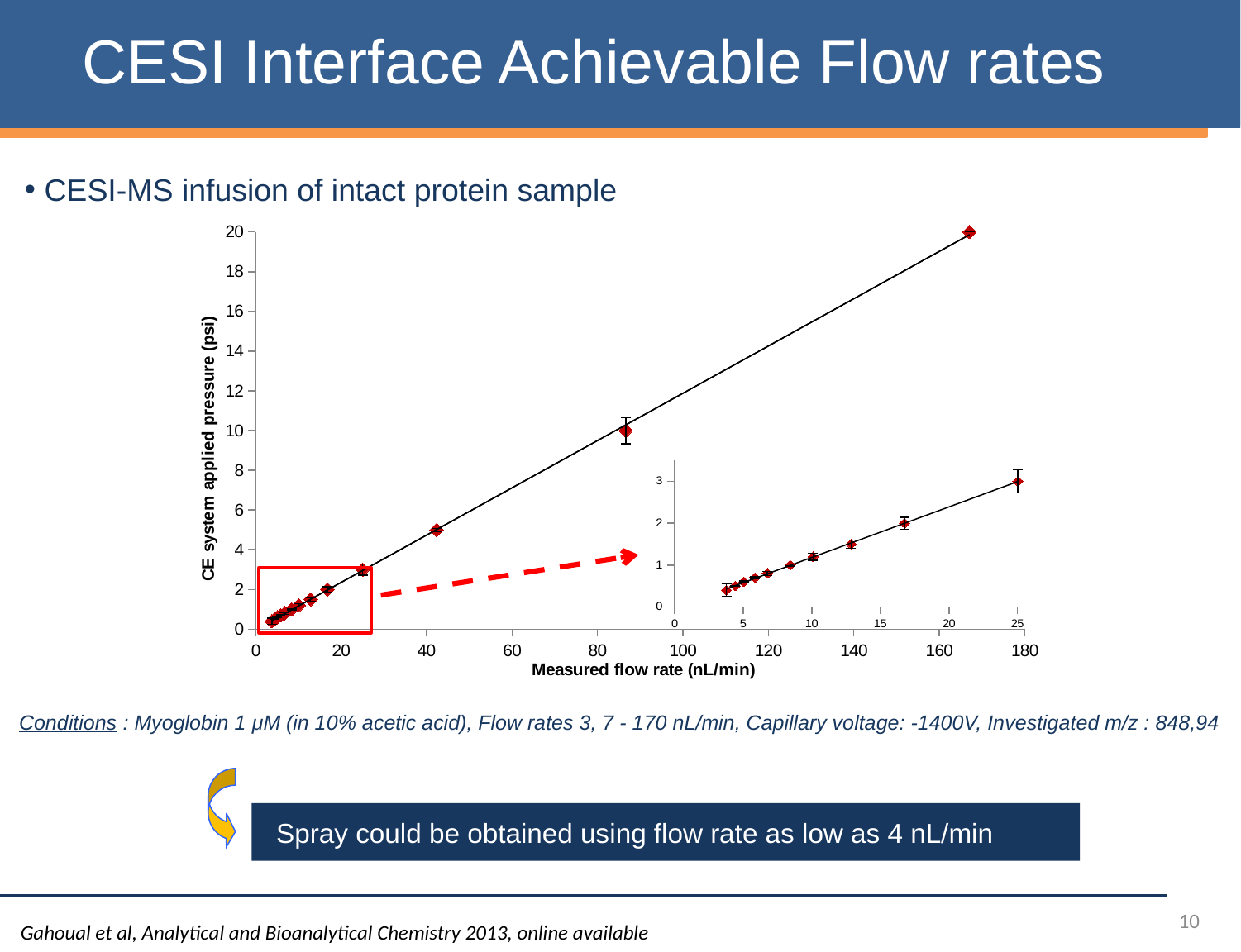
What is the maximum value shown on the x axis of the main chart? 180 In the main chart, is the measured flow rate for the point at 10 psi greater or less than 80 nL/min? greater What is the label of the y axis of the main chart? CE system applied pressure (psi) In the main chart, is the measured flow rate for the point at 20 psi greater or less than 160 nL/min? greater In the inset chart, what is the highest applied pressure plotted? 3 In the main chart, do the applied pressure values rise or fall as the measured flow rate increases? rise What kind of chart is shown on the slide? scatter chart In the main chart, what is the highest applied pressure plotted? 20 psi In the main chart, is the measured flow rate for the point at 5 psi greater or less than 60 nL/min? less In the main chart, which point has the higher applied pressure: the one near 86 nL/min or the one near 42 nL/min? the one near 86 nL/min What is the label of the x axis of the main chart? Measured flow rate (nL/min)